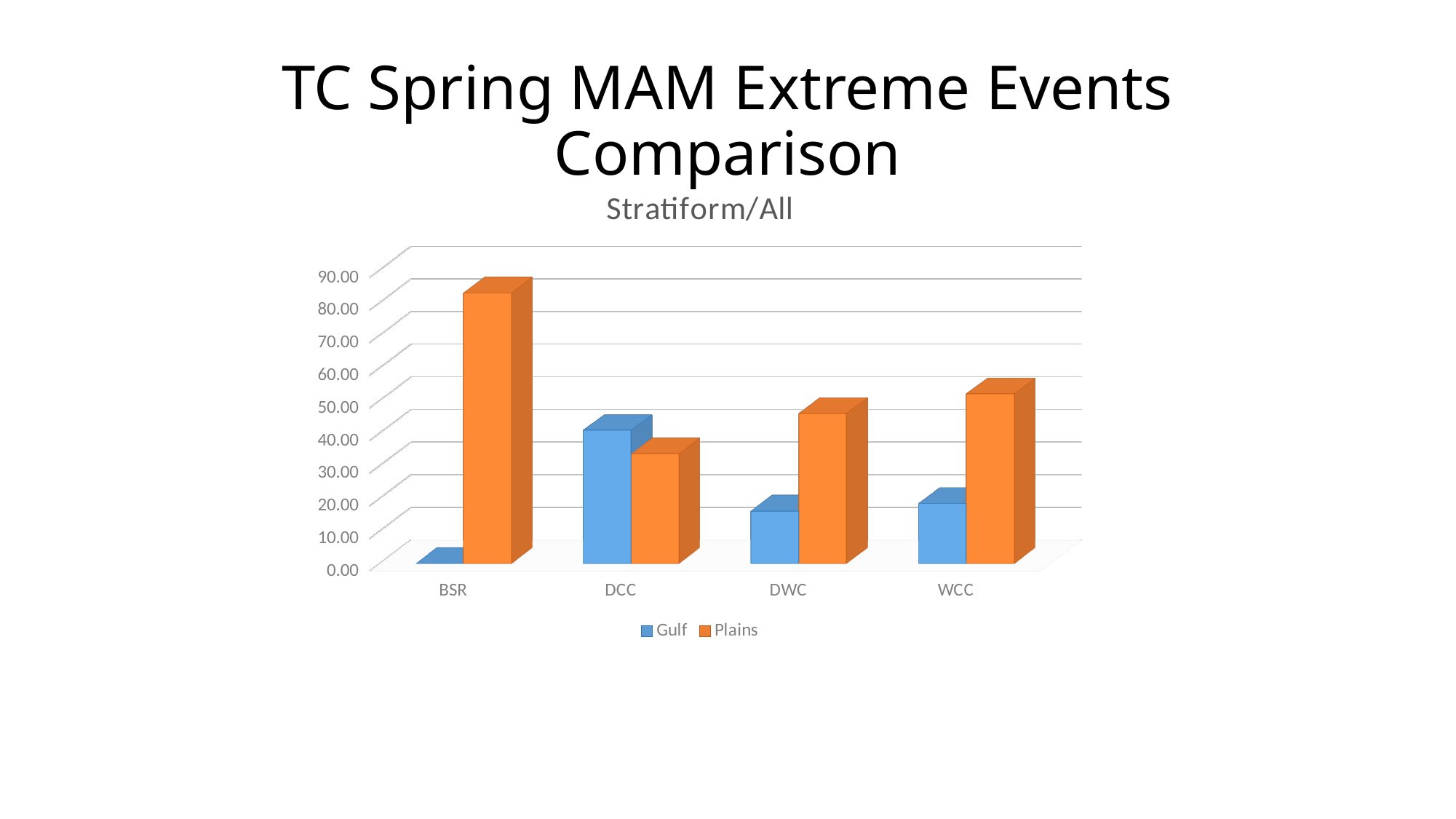
What kind of chart is shown on the slide? bar chart For DWC, which series has the larger value, Gulf or Plains? Plains For DCC, which series has the larger value, Gulf or Plains? Gulf Which category has the highest Plains value? BSR Is the Plains value for BSR greater or less than 70.00? greater How many series does the chart's legend list? 2 Is the Gulf value for DWC greater or less than 30.00? less Which category has the highest Gulf value? DCC Which category has the lowest Plains value? DCC Which category has the lowest Gulf value? BSR What is the title of the chart? Stratiform/All How many categories are shown on the x axis of the chart? 4